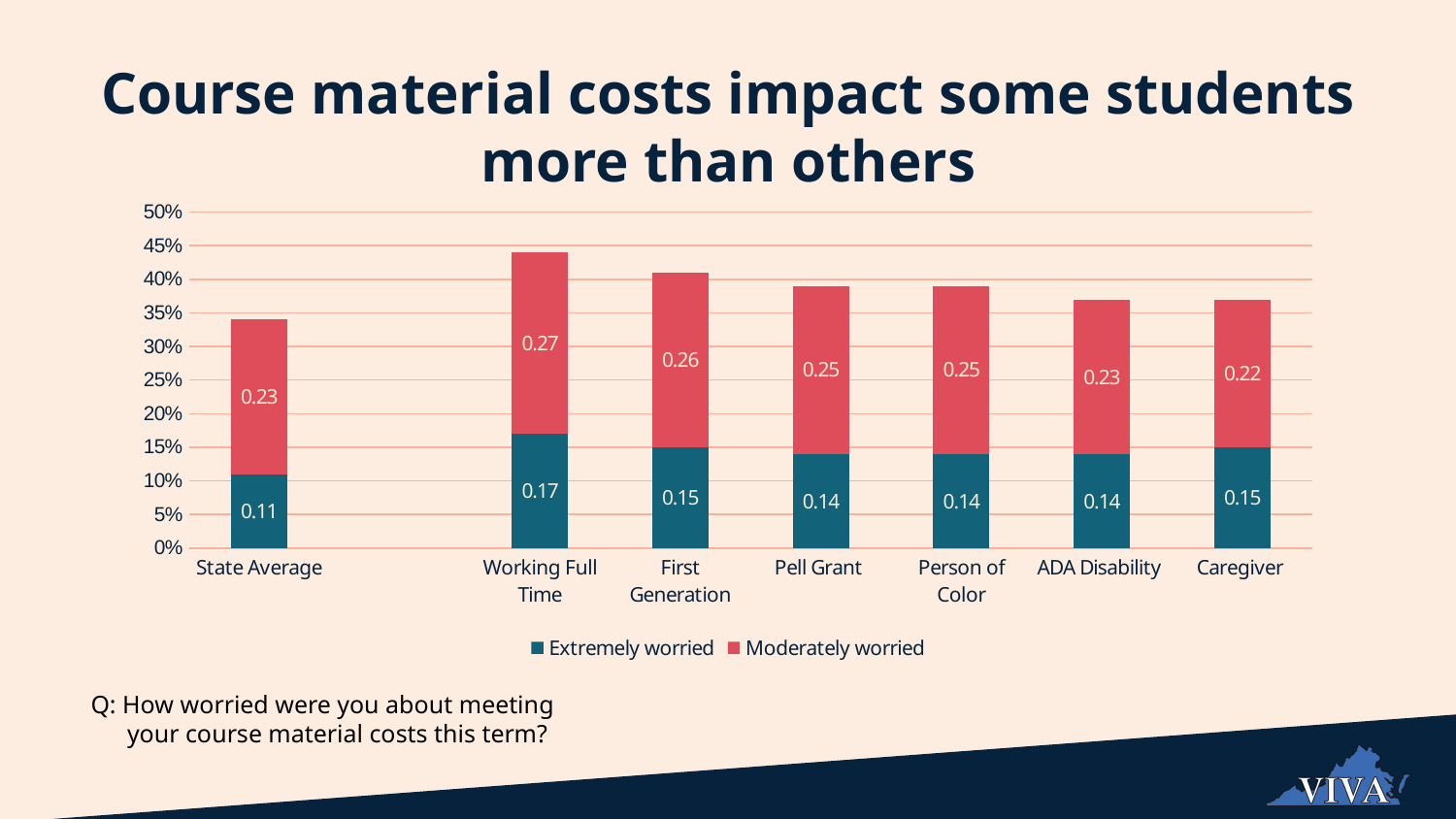
What is the Moderately worried value for State Average? 0.23 Which category has the lowest Extremely worried value? State Average Which series is shown in red in the legend? Moderately worried What is the Extremely worried value for Working Full Time? 0.17 How many categories are shown on the x axis? 7 Which category has the highest Extremely worried value? Working Full Time Which is larger, the Moderately worried value for First Generation or for ADA Disability? First Generation What type of chart is shown on the slide? Stacked bar chart What is the total of the stacked bar for Working Full Time? 0.44 What is the difference between the Moderately worried values for Working Full Time and State Average? 0.04 What is the Moderately worried value for Caregiver? 0.22 How many series does the legend list? 2